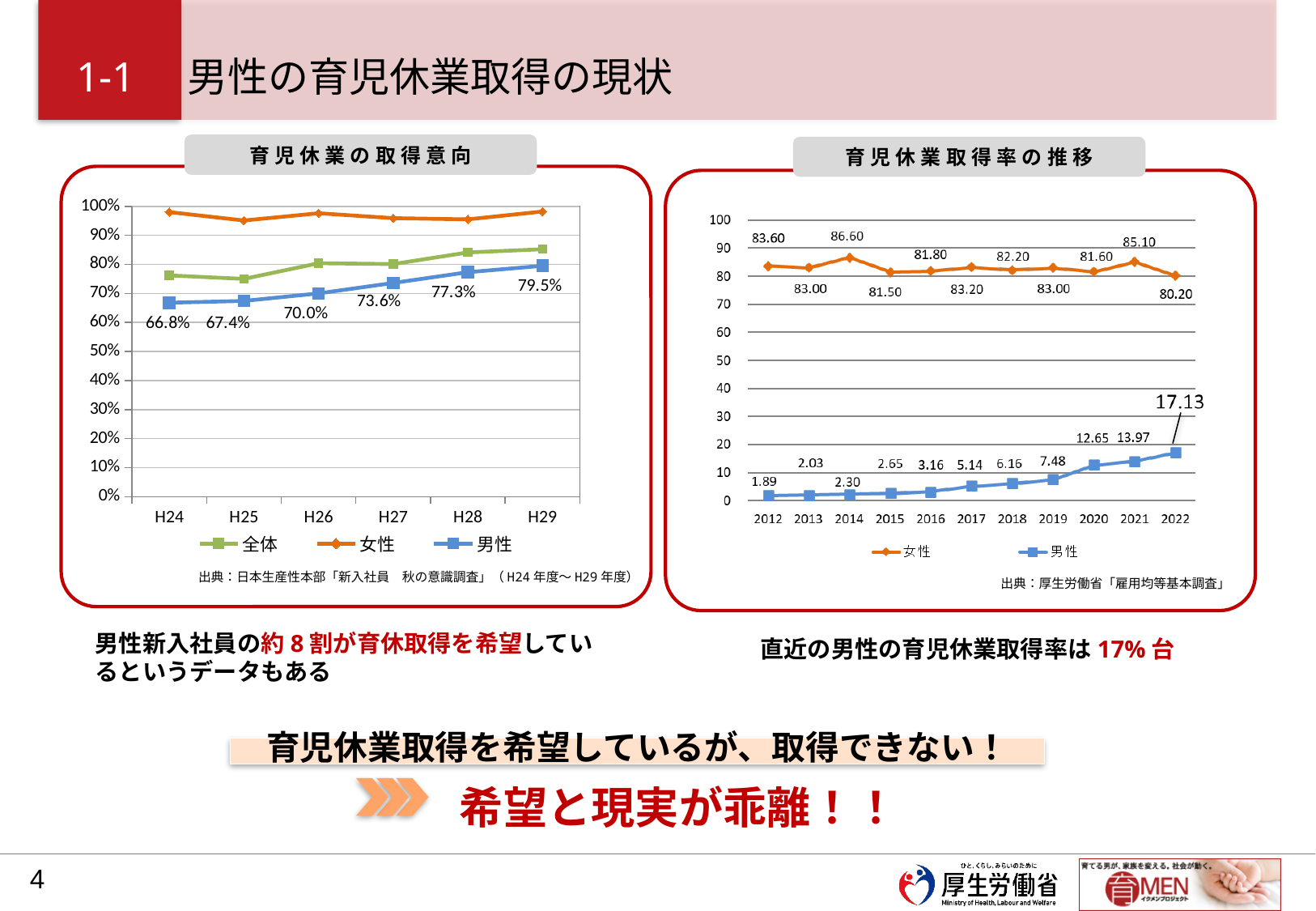
In the 育児休業の取得意向 chart, is the value for 全体 in H24 greater or less than 70%? greater In the 育児休業取得率の推移 chart, in which year is the 女性 value lowest? 2022 In the 育児休業の取得意向 chart, how many series does the legend list? 3 In the 育児休業の取得意向 chart, what is the value for 男性 in H24? 66.8% In the 育児休業取得率の推移 chart, what is the value for 女性 in 2014? 86.60 In the 育児休業取得率の推移 chart, how many years are shown on the x axis? 11 In the 育児休業の取得意向 chart, does the 男性 series rise or fall from H24 to H29? rise In the 育児休業の取得意向 chart, what is the value for 男性 in H29? 79.5% In the 育児休業取得率の推移 chart, what is the value for 男性 in 2022? 17.13 What kind of chart is the 育児休業取得率の推移 chart? line chart In the 育児休業取得率の推移 chart, what is the difference between the 男性 values in 2022 and 2021? 3.16 In the 育児休業の取得意向 chart, what is the difference between the 男性 values in H29 and H24? 12.7%